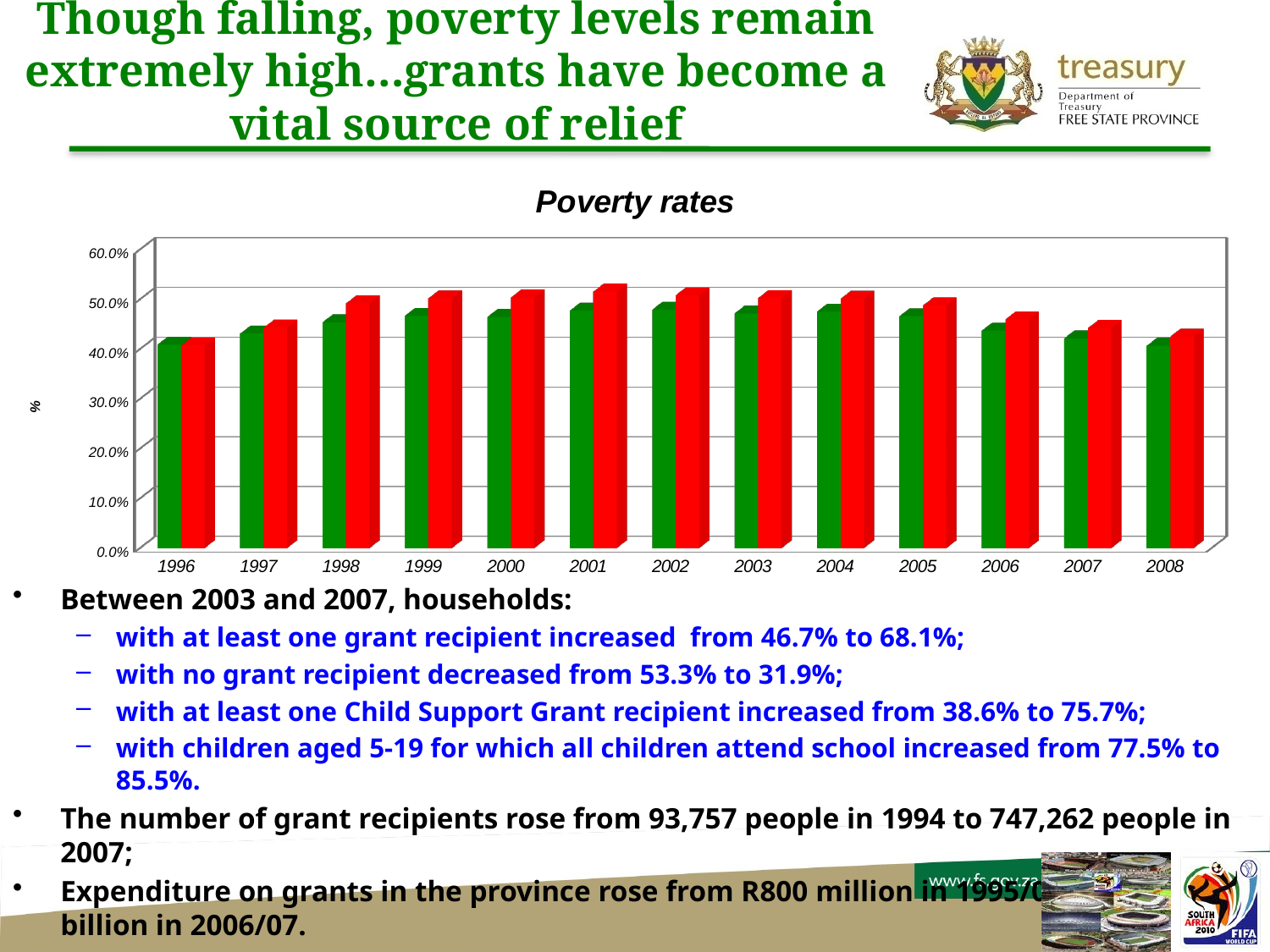
What is the title of the chart? Poverty rates How many years are shown along the x axis of the chart? 13 What is the first year shown on the x axis of the chart? 1996 How many bars are plotted for each year in the chart? 2 Is the value of the green bar for 2008 greater or less than 50.0%? less In 1998, which bar is taller, the green bar or the red bar? the red bar Do the green bars rise or fall from 1996 to 1999? rise Is the value of the red bar for 2001 greater or less than 50.0%? greater Is the value of the red bar for 2006 greater or less than 50.0%? less What kind of chart is shown on the slide? bar chart Do the red bars rise or fall from 2002 to 2008? fall